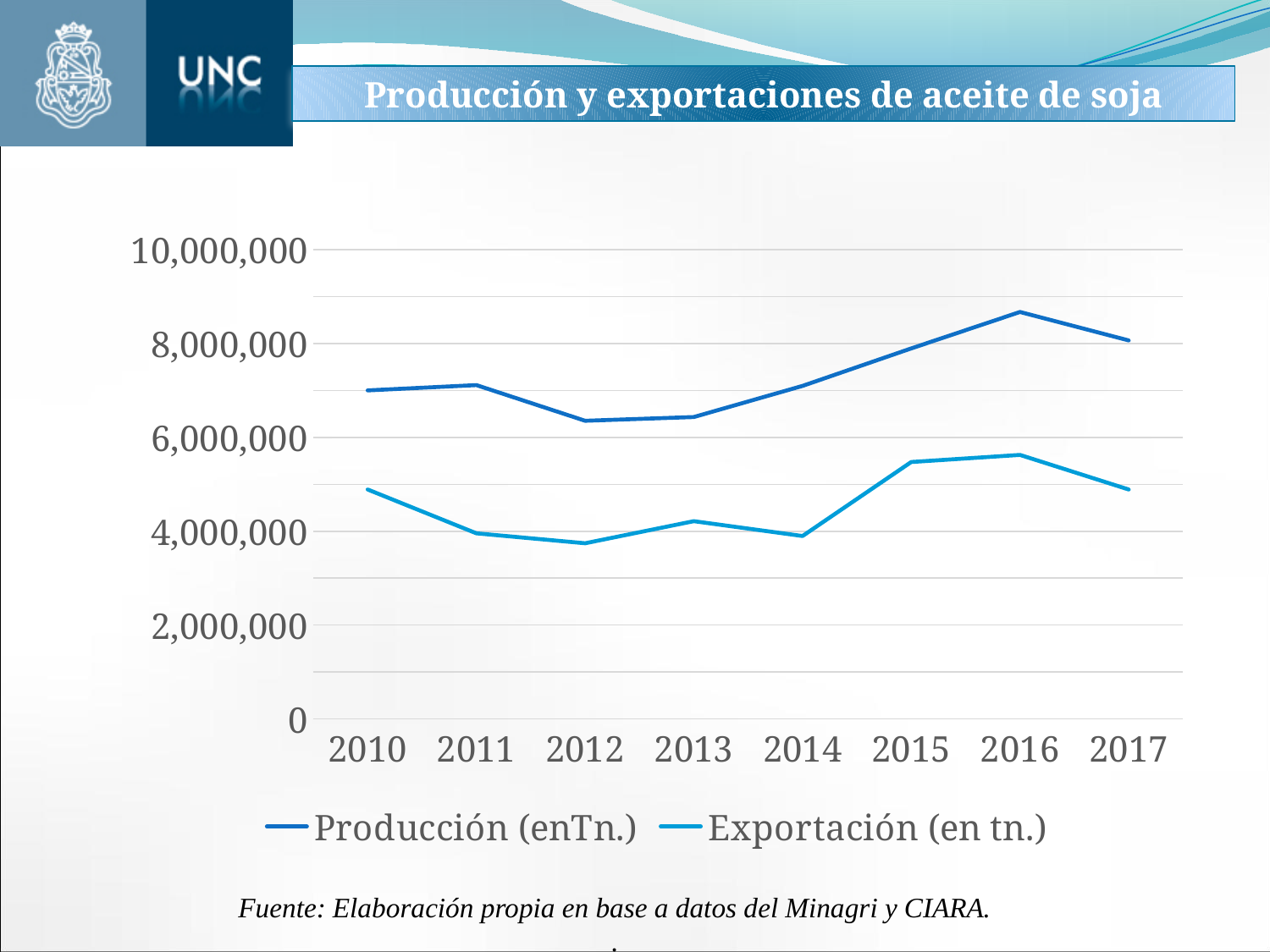
What kind of chart is shown on the slide? Line chart Does Producción (enTn.) rise or fall from 2014 to 2016? rise In which year is Producción (enTn.) highest? 2016 Is the value of Exportación (en tn.) in 2015 greater or less than 4,000,000? greater What is the title of the chart? Producción y exportaciones de aceite de soja Which is larger, Producción (enTn.) in 2016 or in 2010? 2016 Is the value of Producción (enTn.) in 2010 greater or less than 8,000,000? less How many years are shown on the x axis? 8 Is the value of Exportación (en tn.) in 2012 greater or less than 4,000,000? less Which series has the higher value in 2017, Producción (enTn.) or Exportación (en tn.)? Producción (enTn.) How many series does the legend list? 2